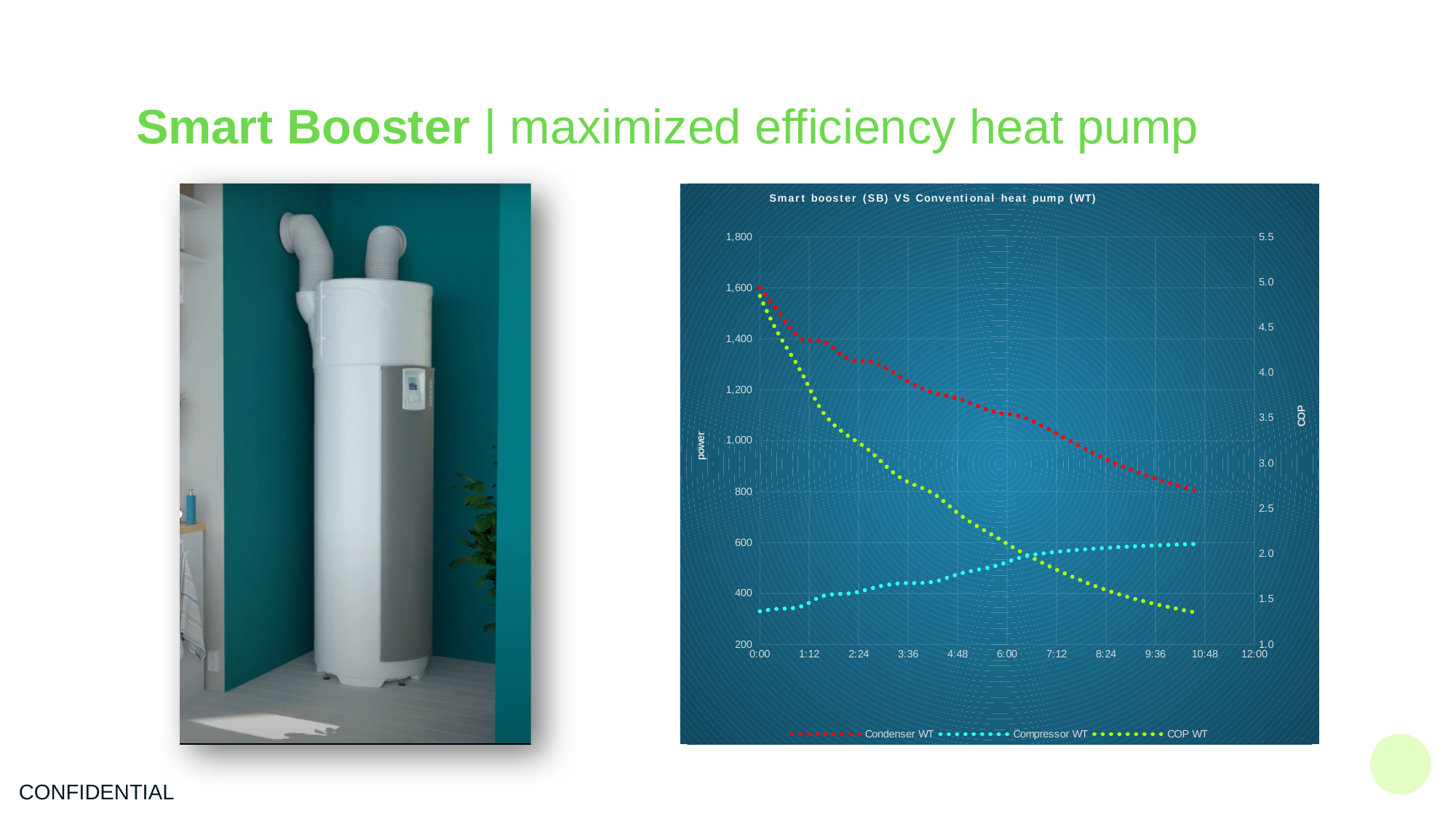
Is the COP WT value at its last point (around 10:48) greater or less than 1.5? less What is the title of the chart? Smart booster (SB) VS Conventional heat pump (WT) How many series does the legend of the chart list? 3 What are the three series named in the chart legend? Condenser WT, Compressor WT, COP WT Is the COP WT value at 0:00 greater or less than 4.5? greater Does the Condenser WT series rise or fall along the x axis? fall What is the label of the right-hand vertical axis of the chart? COP Does the COP WT series rise or fall along the x axis? fall Is the value for Compressor WT at 0:00 greater or less than 400? less At 0:00, which is larger on the power axis: Condenser WT or Compressor WT? Condenser WT Does the Compressor WT series rise or fall along the x axis? rise